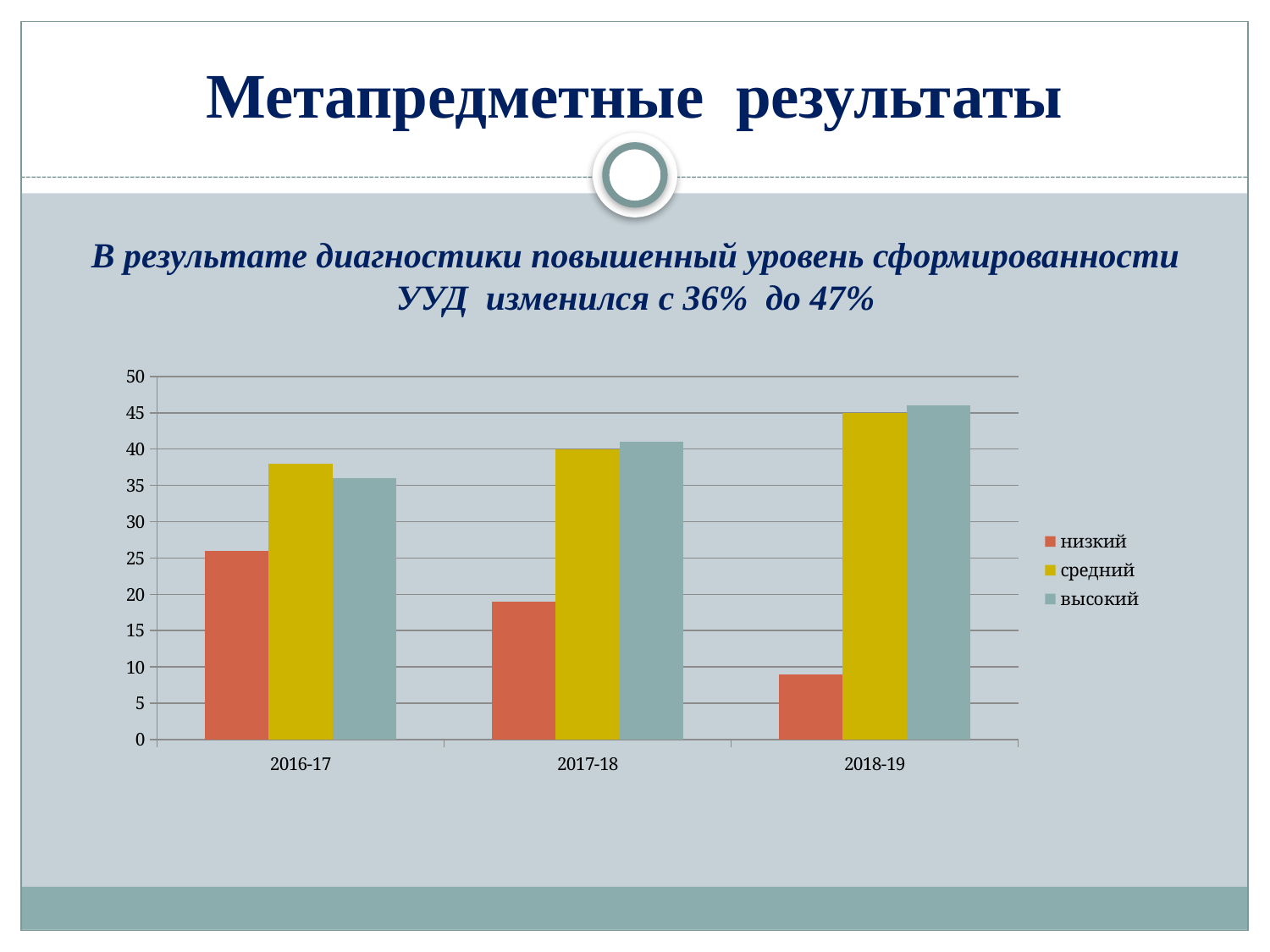
Does the value for низкий rise or fall from 2016-17 to 2018-19? fall Is the value for низкий in 2018-19 greater or less than 15? less How many year categories are shown on the x axis? 3 Is the value for низкий in 2016-17 greater or less than 30? less Which series is lowest in 2016-17? низкий Does the value for высокий rise or fall from 2016-17 to 2018-19? rise What kind of chart is shown on the slide? bar chart How many series does the legend list? 3 Which is larger in 2017-18, низкий or средний? средний Is the value for высокий in 2018-19 greater or less than 40? greater Which series is lowest in 2018-19? низкий